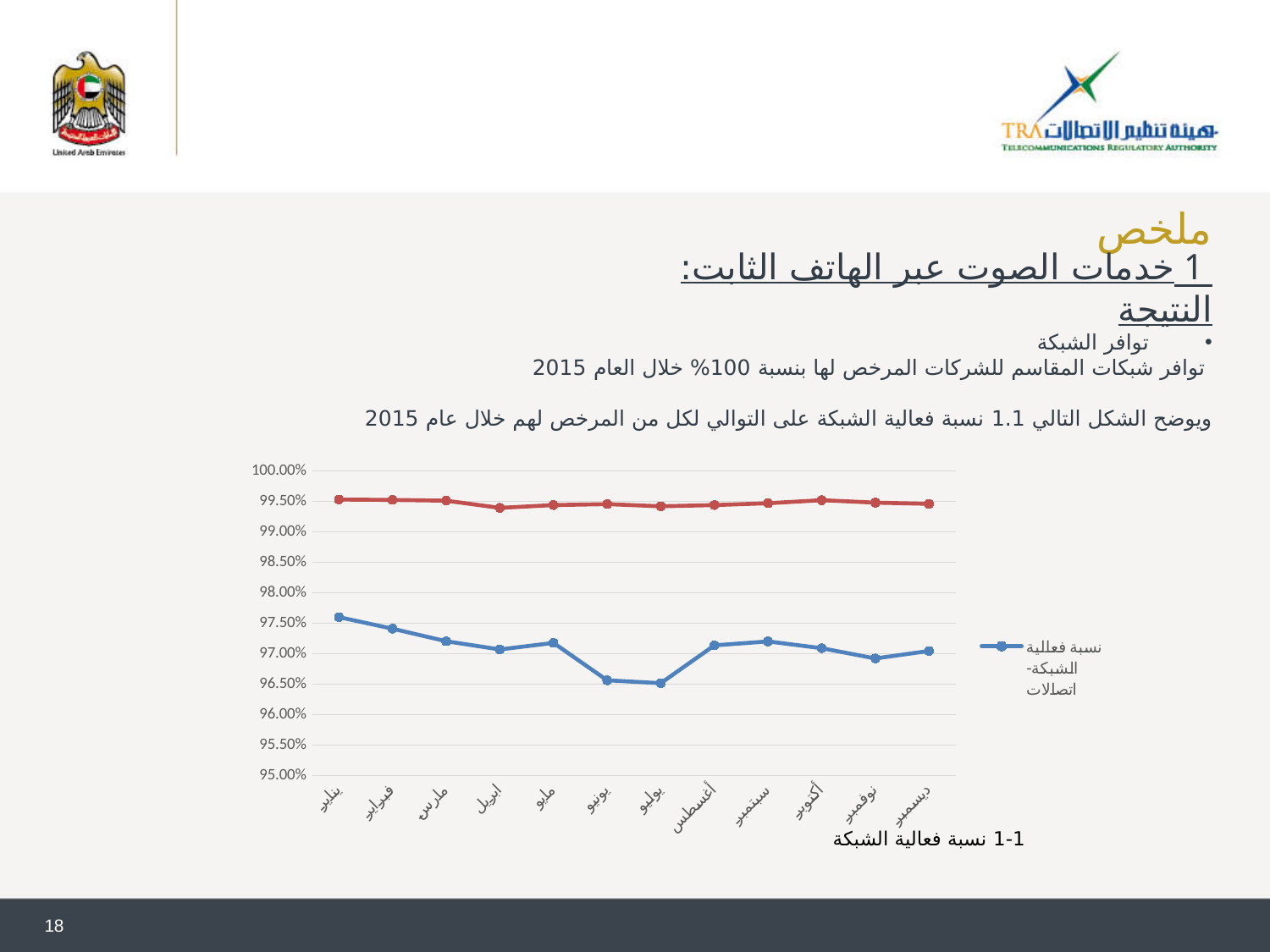
In which month does the blue line (نسبة فعالية الشبكة- اتصالات) reach its highest value? يناير How many months are plotted along the x axis of the chart? 12 Is the value of the red line for ابريل greater or less than 99.00%? greater Is the value of the blue line for يوليو greater or less than 97.00%? less What legend entry is shown for the blue line? نسبة فعالية الشبكة- اتصالات Does the blue line rise or fall from يناير to ابريل? fall Is the value of the blue line for يناير greater or less than 97.00%? greater In مايو, which line has the higher value, the red line or the blue line? the red line What kind of chart is shown on the slide? line chart What is the caption printed below the chart? 1-1 نسبة فعالية الشبكة Which is larger for the blue line: the value for يناير or the value for يوليو? يناير